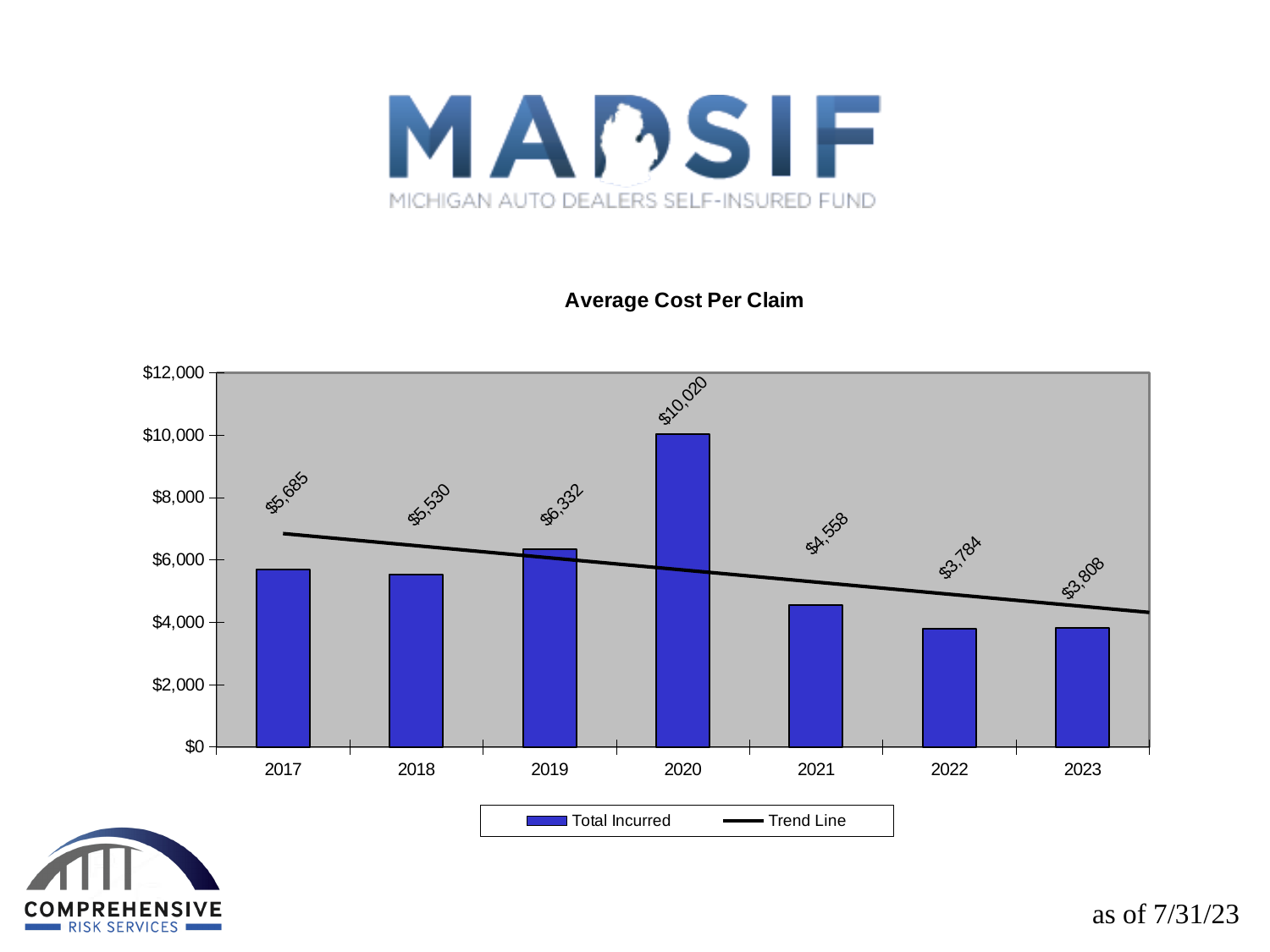
What is the average cost per claim for 2020? $10,020 What is the average cost per claim for 2022? $3,784 Which year has the highest average cost per claim? 2020 What is the difference between the average cost per claim in 2020 and 2019? $3,688 What kind of chart is used to show the average cost per claim? Bar chart What is the average cost per claim for 2017? $5,685 Is the value for 2021 greater or less than $4,000? greater How many years are shown on the x axis of the chart? 7 Which year has the lowest average cost per claim? 2022 Which year has a higher average cost per claim, 2018 or 2021? 2018 Does the trend line rise or fall from 2017 to 2023? Falls How many series does the legend list? 2